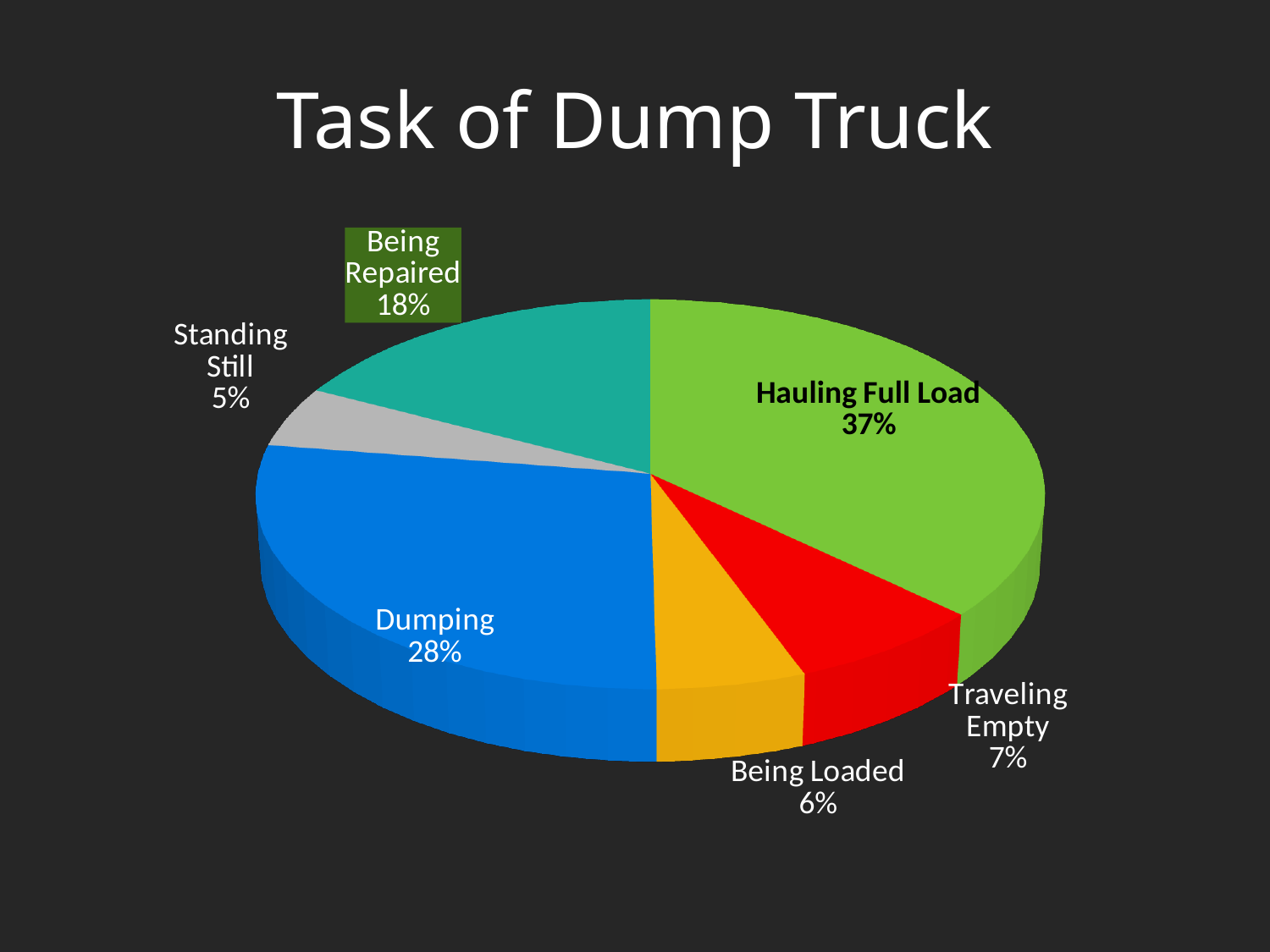
How many slices does the pie chart have? 6 Which task has the smallest share of the pie? Standing Still What is the difference between Hauling Full Load and Dumping? 9% What is the title of the chart? Task of Dump Truck What is the value for Being Repaired? 18% Which is larger, Traveling Empty or Being Loaded? Traveling Empty Which task has the largest share of the pie? Hauling Full Load What is the value for Standing Still? 5% What share of the pie is Hauling Full Load? 37% What kind of chart is shown on the slide? pie chart What is the value for Dumping? 28% What is the value for Traveling Empty? 7%